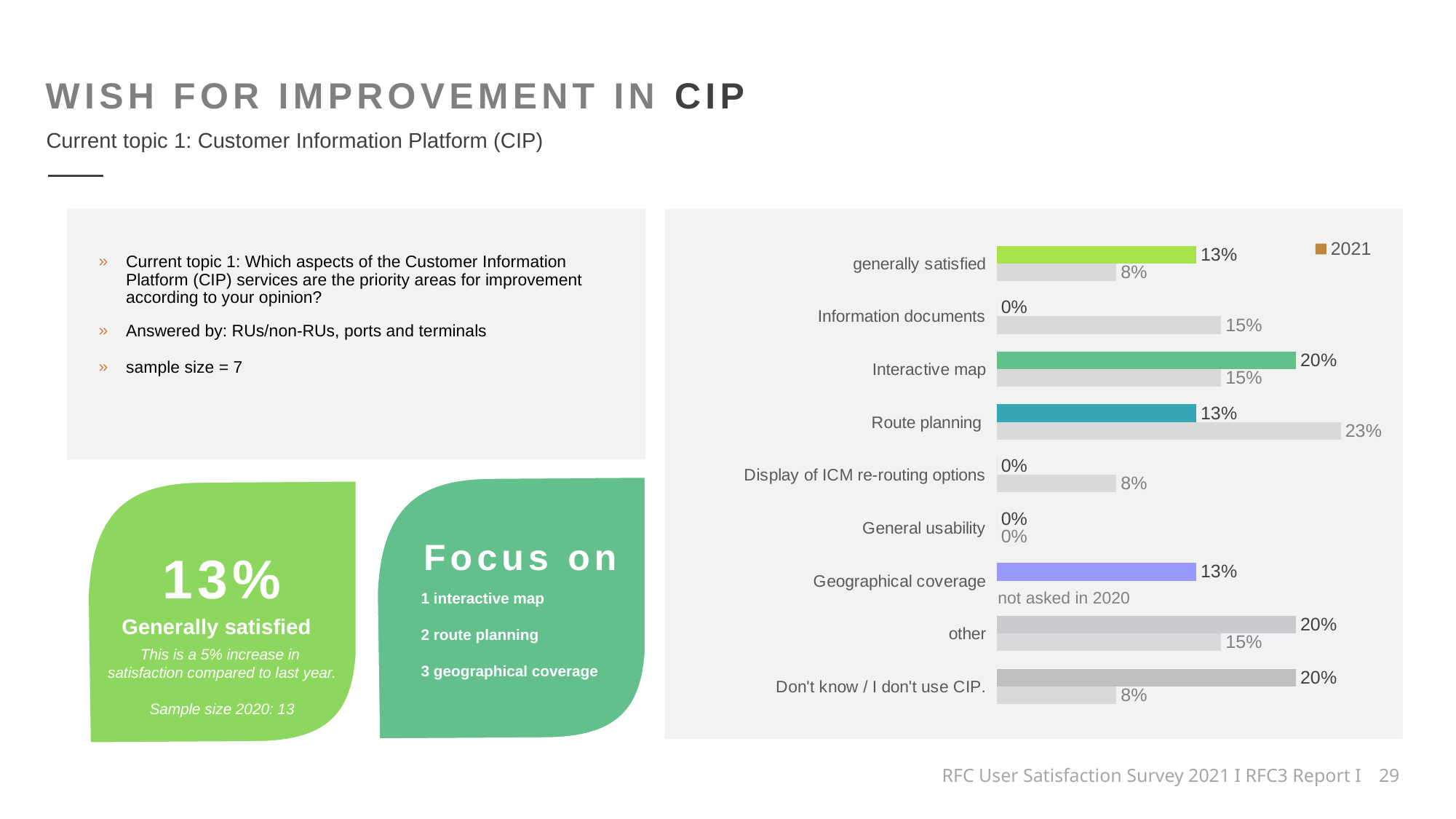
What kind of chart is shown on the slide? Bar chart Which series is listed in the chart legend? 2021 How many categories are shown on the chart? 9 What is the 2020 value for Route planning? 23% What is the difference between the 2021 and 2020 values for generally satisfied? 5% What is the 2021 value for generally satisfied? 13% Which is larger for Interactive map, the 2021 value or the 2020 value? 2021 value What is the difference between the 2020 and 2021 values for Route planning? 10% Which category has the highest 2020 value? Route planning What is the 2020 value for Information documents? 15% What is shown in place of a 2020 value for Geographical coverage? not asked in 2020 What is the 2021 value for Interactive map? 20%